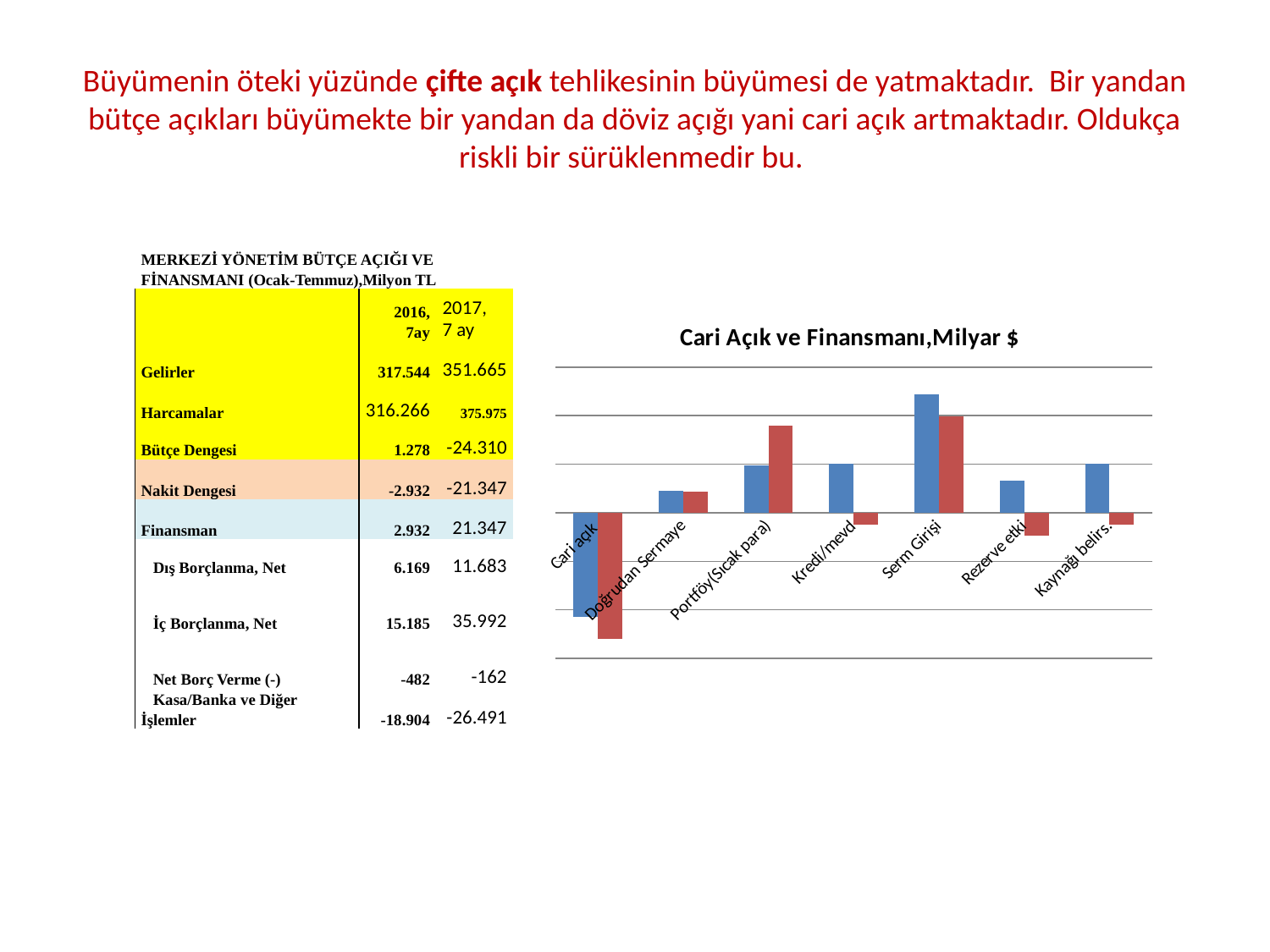
What is the title of the chart on the slide? Cari Açık ve Finansmanı,Milyar $ How many categories have a red bar below the zero line? 4 Which has the larger red bar, Portföy(Sıcak para) or Doğrudan Sermaye? Portföy(Sıcak para) Which category has the lowest red bar in the chart? Cari açık Which category has the tallest red bar in the chart? Serm Girişi Which has the larger blue bar, Serm Girişi or Kredi/mevd? Serm Girişi How many categories are shown on the x axis of the chart? 7 Which category has the tallest blue bar in the chart? Serm Girişi What kind of chart is shown on the slide? bar chart Which category has the lowest blue bar in the chart? Cari açık Is the blue bar for Rezerve etki above or below the zero line? above What two colours are used for the bars in the chart? blue and red